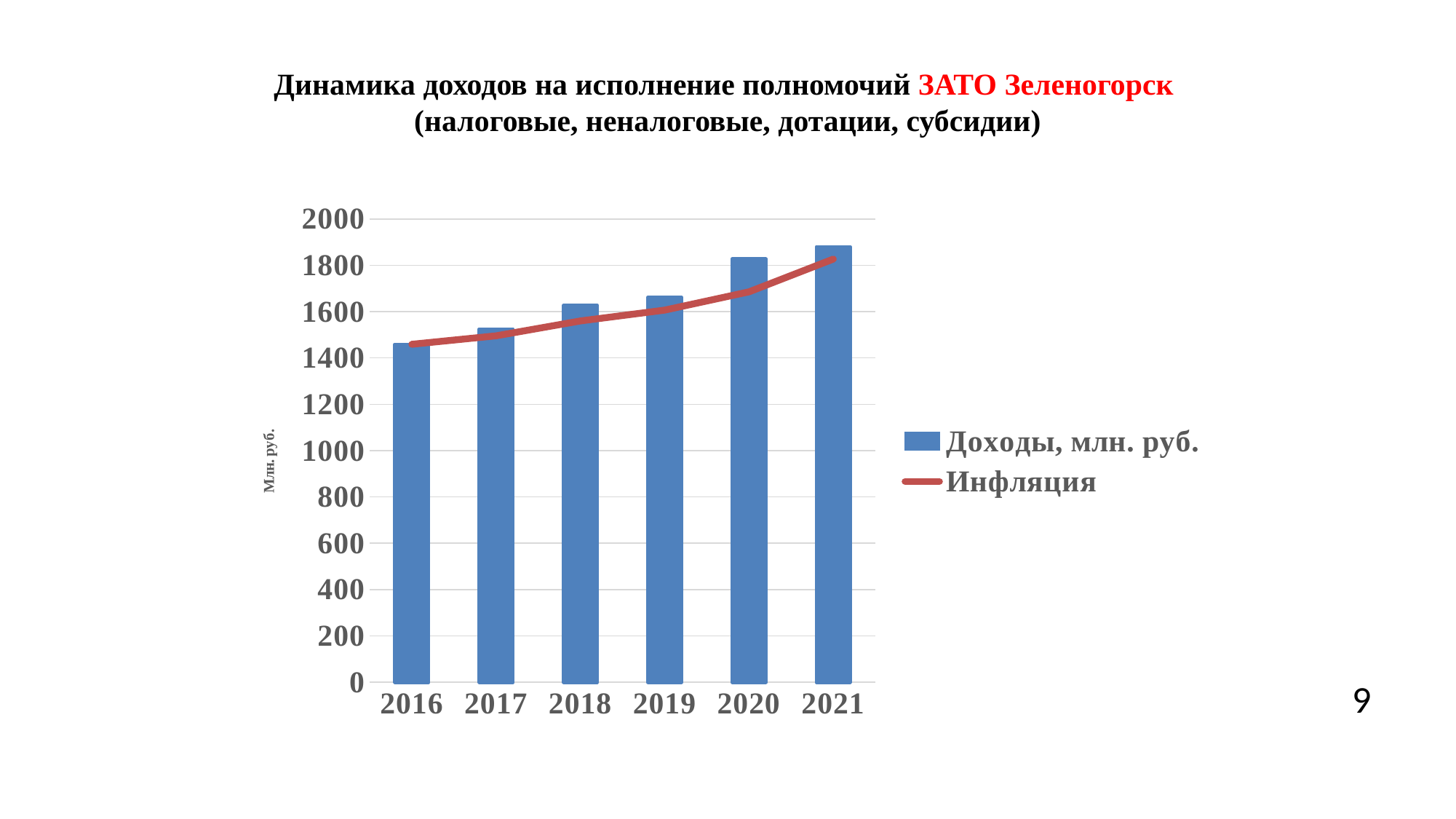
What kind of chart is shown on the slide? A bar chart with a line How many series does the legend list? 2 Do the values for Доходы, млн. руб. rise or fall from 2016 to 2021? Rise How many years are shown on the x axis of the chart? 6 Which year has the larger value for Доходы, млн. руб., 2019 or 2020? 2020 Is the value for Доходы, млн. руб. in 2016 greater or less than 1400? greater Which year has the lowest value for Доходы, млн. руб.? 2016 Is the value for Доходы, млн. руб. in 2017 greater or less than 1600? less Which series is drawn as a red line in the chart? Инфляция What is the label on the vertical axis of the chart? Млн. руб. Which year has the highest value for Доходы, млн. руб.? 2021 Is the value for Доходы, млн. руб. in 2021 greater or less than 2000? less